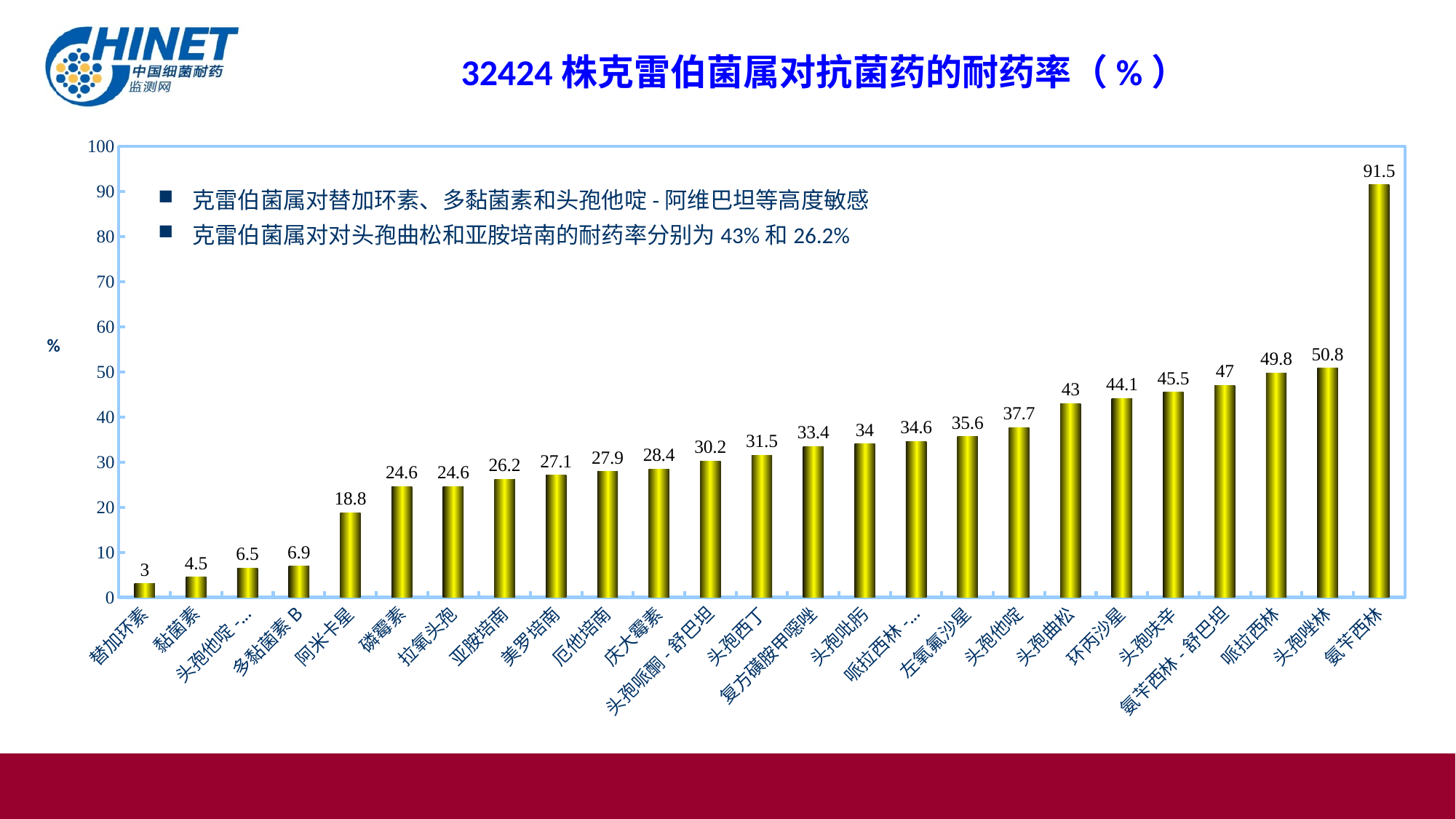
Which antibiotic has the highest resistance rate? 氨苄西林 What is the resistance rate for 阿米卡星? 18.8 What is the difference between the resistance rates of 氨苄西林 and 头孢唑林? 40.7 How many antibiotics are shown on the x axis? 25 What is the difference between the resistance rates of 头孢唑林 and 哌拉西林? 1 What is the resistance rate for 亚胺培南? 26.2 Do the values rise or fall from left to right along the x axis? rise What is the resistance rate for 头孢曲松? 43 What is the resistance rate for 氨苄西林? 91.5 Which has a higher resistance rate, 环丙沙星 or 左氧氟沙星? 环丙沙星 What type of chart is shown on the slide? bar chart Which antibiotic has the lowest resistance rate? 替加环素